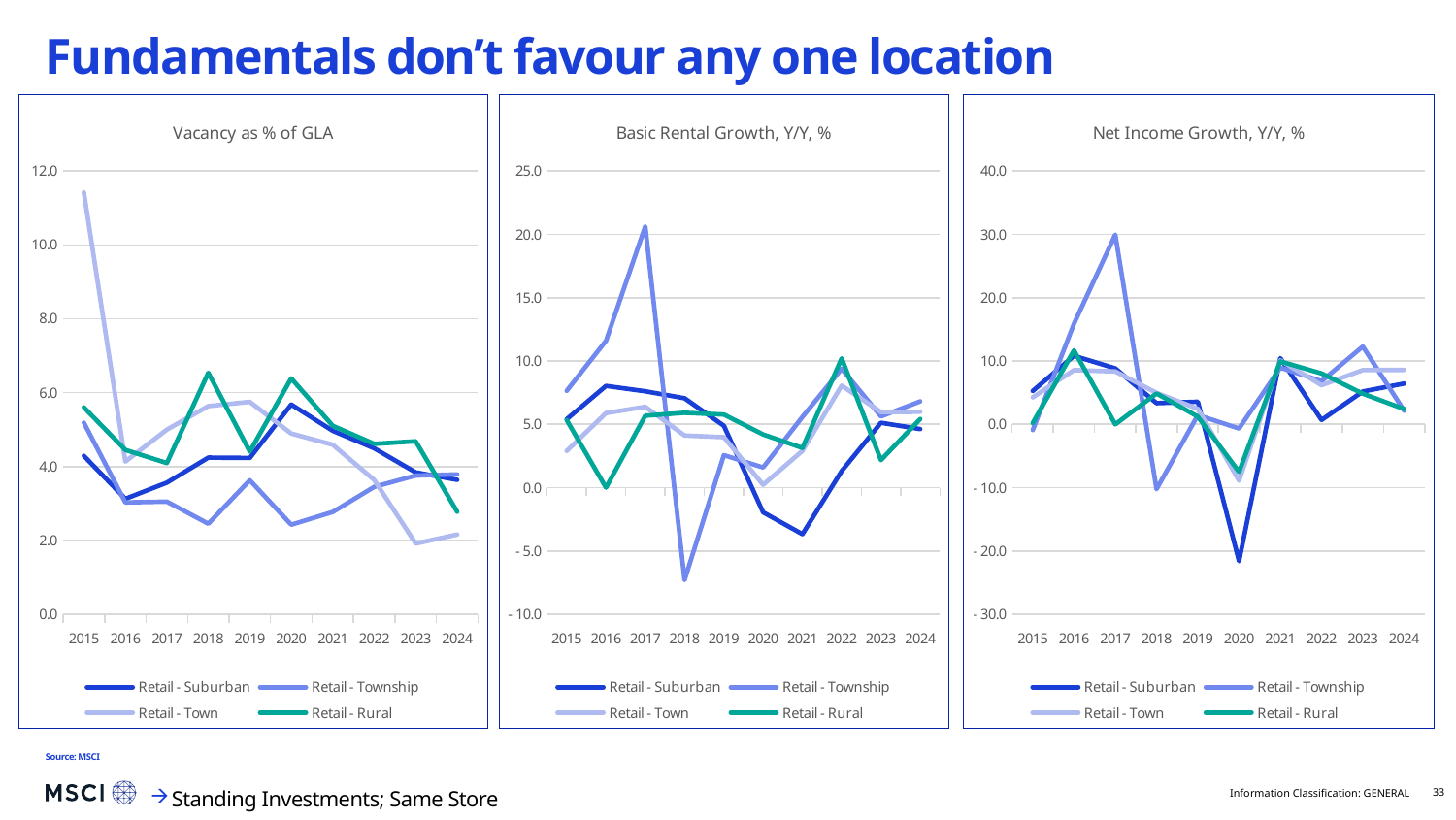
In the "Basic Rental Growth, Y/Y, %" chart, is the value for Retail - Township in 2017 greater or less than 15.0? greater In the "Vacancy as % of GLA" chart, is the value for Retail - Township in 2018 greater or less than 4.0? less In the "Vacancy as % of GLA" chart, which series has the highest value in 2015? Retail - Town In the "Basic Rental Growth, Y/Y, %" chart, is the value for Retail - Suburban in 2021 greater or less than 0.0? less What is the title of the middle chart on the slide? Basic Rental Growth, Y/Y, % In the "Net Income Growth, Y/Y, %" chart, which series has the lowest value in 2020? Retail - Suburban In the "Vacancy as % of GLA" chart, does the Retail - Town series rise or fall from 2019 to 2023? fall In the "Basic Rental Growth, Y/Y, %" chart, which series has the highest value in 2017? Retail - Township How many series does the legend of the "Basic Rental Growth, Y/Y, %" chart list? 4 How many years are shown on the x axis of the "Net Income Growth, Y/Y, %" chart? 10 What kind of chart is the "Vacancy as % of GLA" chart? line chart